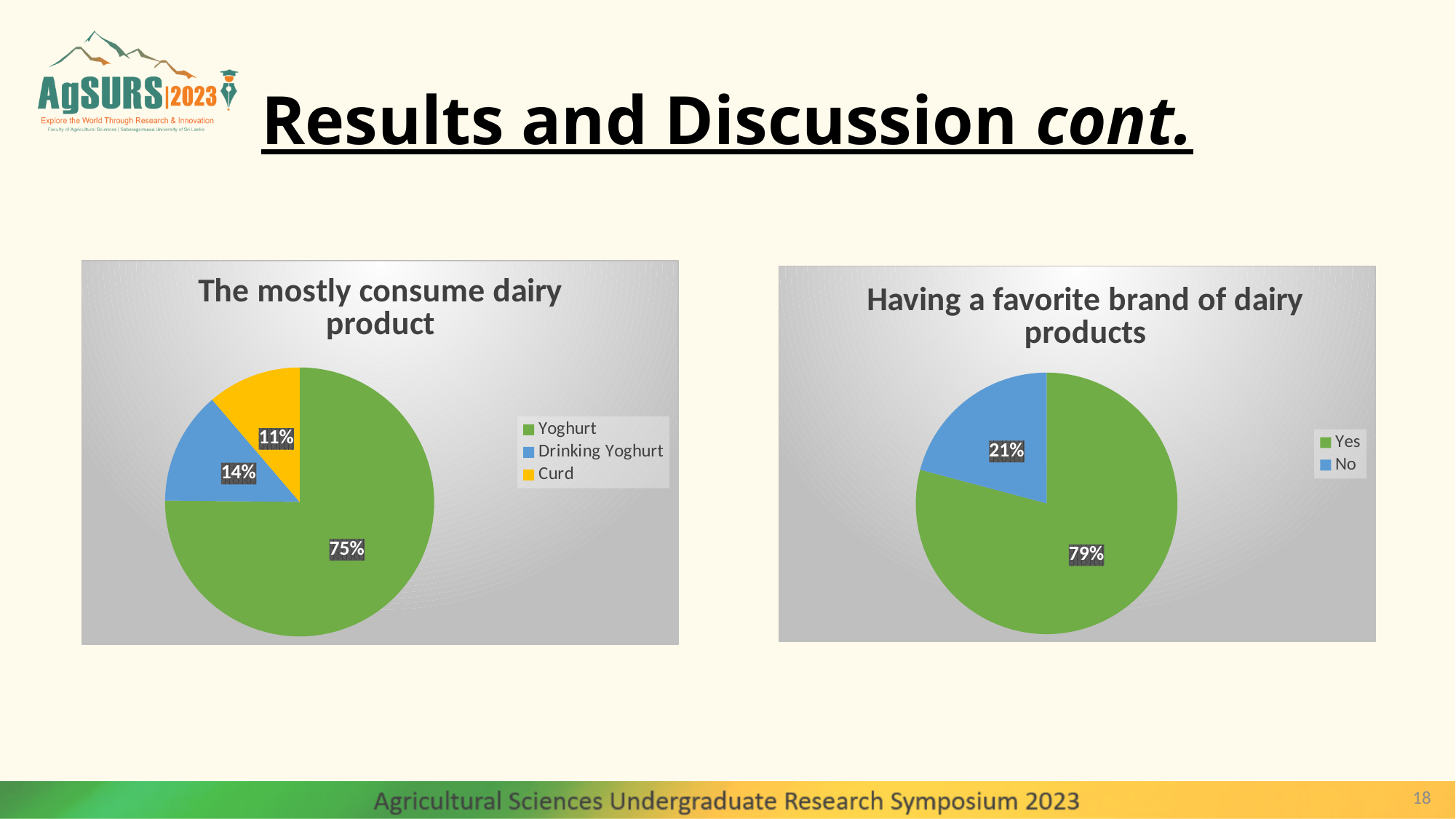
In the chart titled 'The mostly consume dairy product', which category has the largest share? Yoghurt In the chart titled 'Having a favorite brand of dairy products', what percentage answered No? 21% In the chart titled 'The mostly consume dairy product', what percentage is shown for Drinking Yoghurt? 14% In the chart titled 'The mostly consume dairy product', what percentage is shown for Yoghurt? 75% What type of chart is used in the chart titled 'Having a favorite brand of dairy products'? Pie chart In the chart titled 'The mostly consume dairy product', how many categories does the legend list? 3 In the chart titled 'Having a favorite brand of dairy products', which is larger, Yes or No? Yes In the chart titled 'Having a favorite brand of dairy products', what percentage answered Yes? 79% In the chart titled 'Having a favorite brand of dairy products', what colour represents the No slice? Blue In the chart titled 'The mostly consume dairy product', which category has the smallest share? Curd In the chart titled 'The mostly consume dairy product', what percentage is shown for Curd? 11% In the chart titled 'The mostly consume dairy product', what is the difference in percentage points between Yoghurt and Drinking Yoghurt? 61